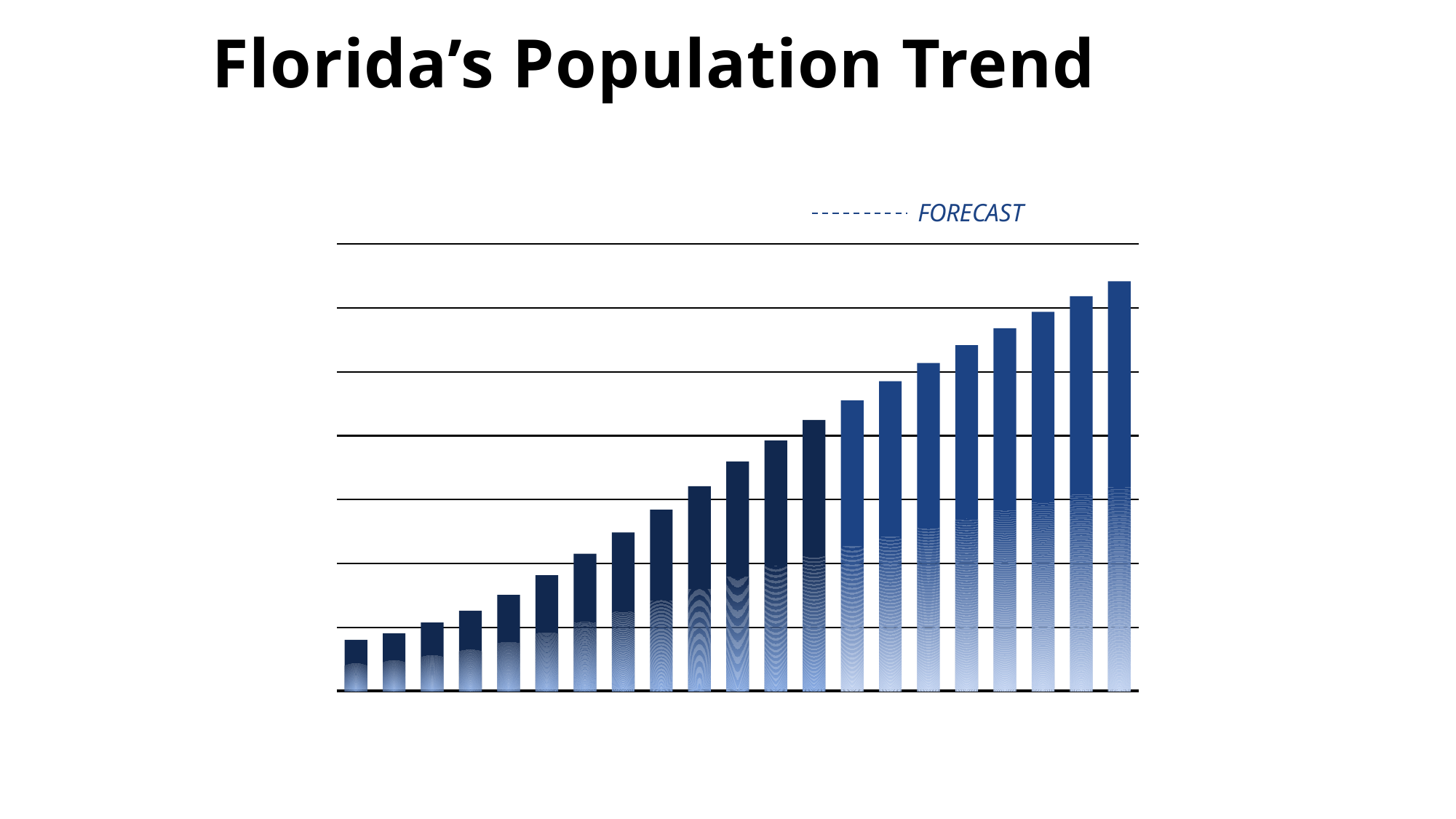
What kind of chart is shown on the slide? bar chart Do the bar values rise or fall from left to right along the x axis? rise How many bars are plotted in the chart? 21 What is the title of the slide containing the chart? Florida's Population Trend What label appears next to the dashed line above the chart? FORECAST